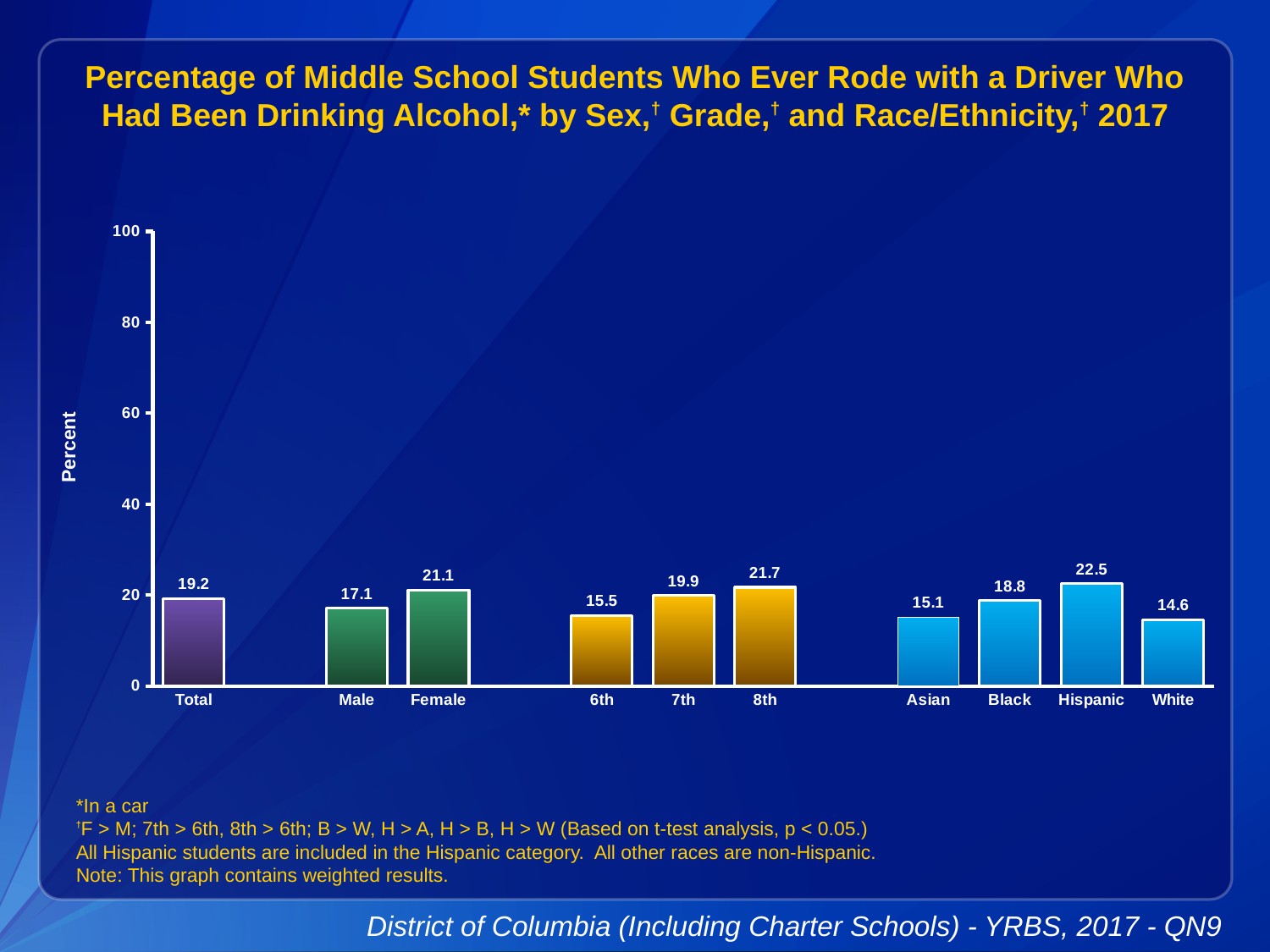
What is the value for 8th grade? 21.7 What is the difference between the Female and Male values? 4.0 Which category has the lowest value? White Do the values rise or fall from 6th grade to 8th grade? rise Which category has the highest value? Hispanic What kind of chart is this? bar chart What is the label on the y axis? Percent What is the value for Female? 21.1 How many categories are shown on the x axis? 10 Which is larger, the value for 7th grade or the value for 6th grade? 7th Is the value for Black greater or less than 20? less What is the value for Total? 19.2